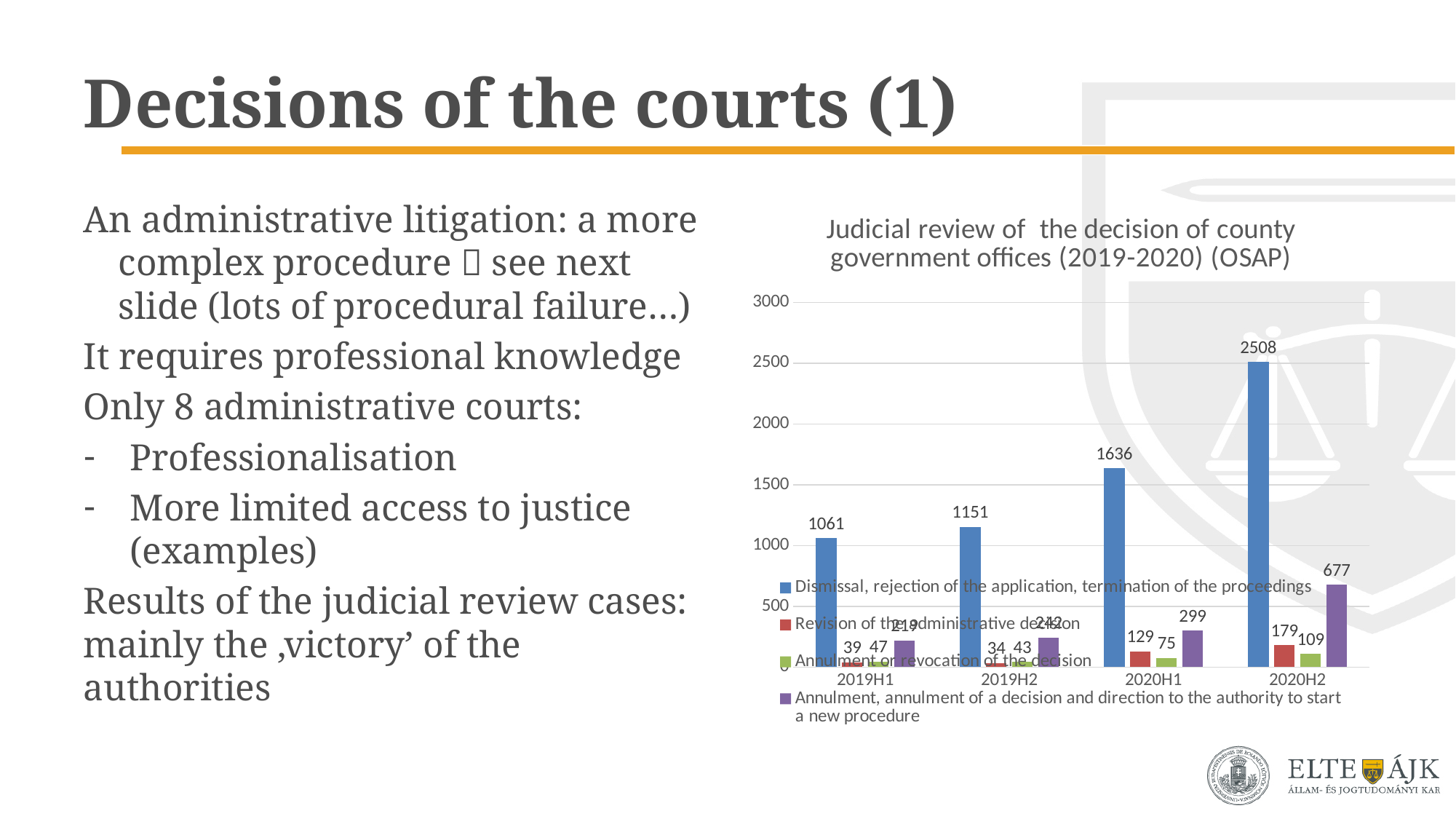
How many series does the chart legend list? 4 What kind of chart is shown on the slide? bar chart In which period is the 'Revision of the administrative decision' value lowest? 2019H2 What is the title of the chart? Judicial review of the decision of county government offices (2019-2020) (OSAP) How many periods are shown on the x axis of the chart? 4 Does the 'Dismissal, rejection of the application, termination of the proceedings' value rise or fall from 2019H1 to 2020H2? rise What is the value for 'Dismissal, rejection of the application, termination of the proceedings' in 2020H2? 2508 What is the value for 'Annulment or revocation of the decision' in 2019H1? 47 What is the difference between the 'Dismissal, rejection of the application, termination of the proceedings' values in 2020H2 and 2020H1? 872 What is the value for 'Annulment, annulment of a decision and direction to the authority to start a new procedure' in 2020H2? 677 What is the value for 'Revision of the administrative decision' in 2020H1? 129 In which period is the 'Dismissal, rejection of the application, termination of the proceedings' value highest? 2020H2